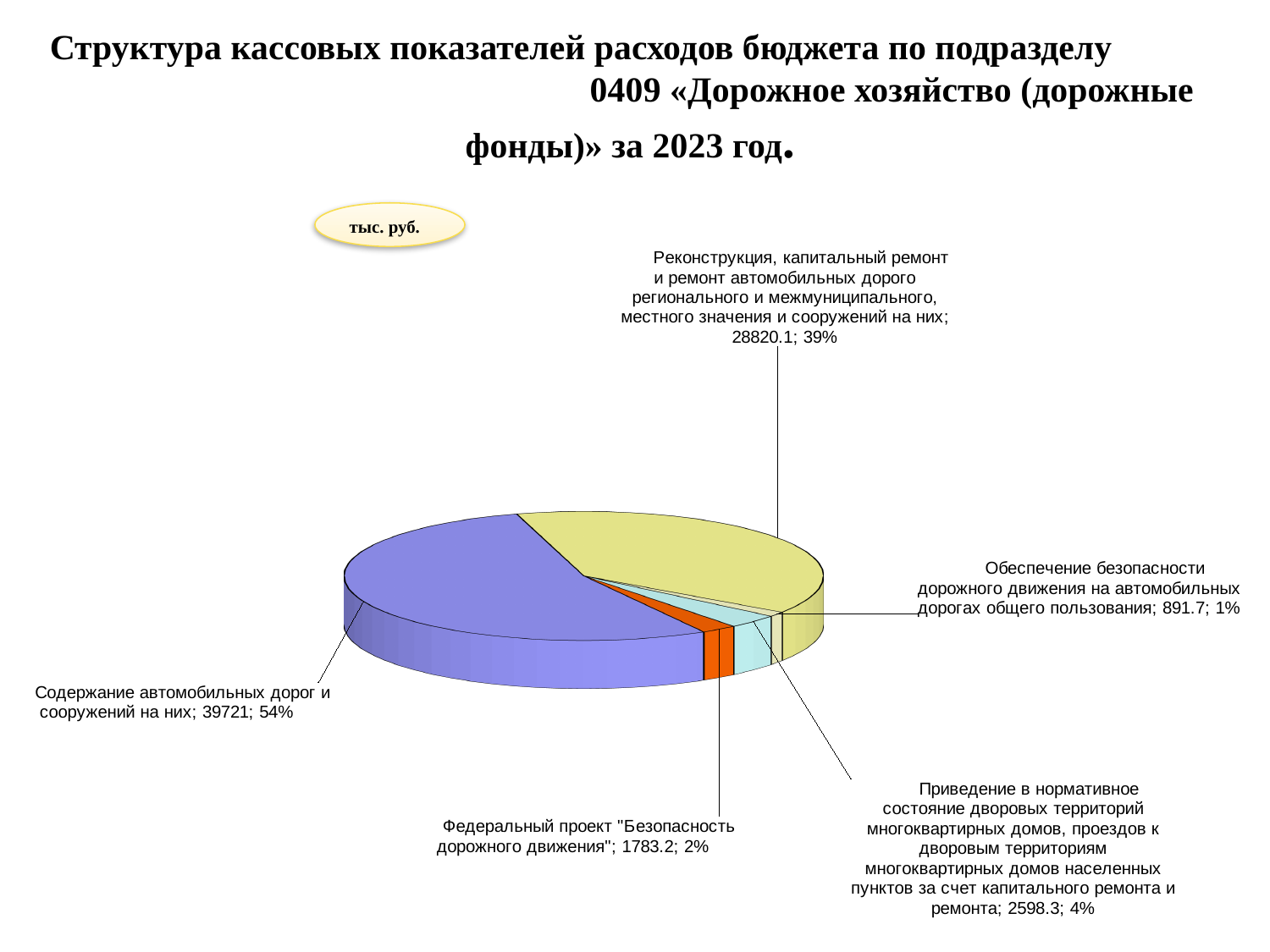
Which is larger: the value for "Приведение в нормативное состояние дворовых территорий..." or the value for "Федеральный проект "Безопасность дорожного движения""? Приведение в нормативное состояние дворовых территорий... What unit of measurement is indicated on the slide for the chart values? тыс. руб. What kind of chart is shown on the slide? Pie chart What share of the pie does "Приведение в нормативное состояние дворовых территорий многоквартирных домов..." represent? 4% What is the value for "Содержание автомобильных дорог и сооружений на них"? 39721 What is the value for "Федеральный проект "Безопасность дорожного движения""? 1783.2 Which category has the smallest slice of the pie? Обеспечение безопасности дорожного движения на автомобильных дорогах общего пользования What share of the pie does "Реконструкция, капитальный ремонт и ремонт автомобильных дорого регионального и межмуниципального, местного значения и сооружений на них" represent? 39% What is the difference between the values for "Содержание автомобильных дорог и сооружений на них" and "Реконструкция, капитальный ремонт и ремонт автомобильных дорого..."? 10900.9 What is the value for "Обеспечение безопасности дорожного движения на автомобильных дорогах общего пользования"? 891.7 Which category has the largest slice of the pie? Содержание автомобильных дорог и сооружений на них How many slices does the pie chart have? 5